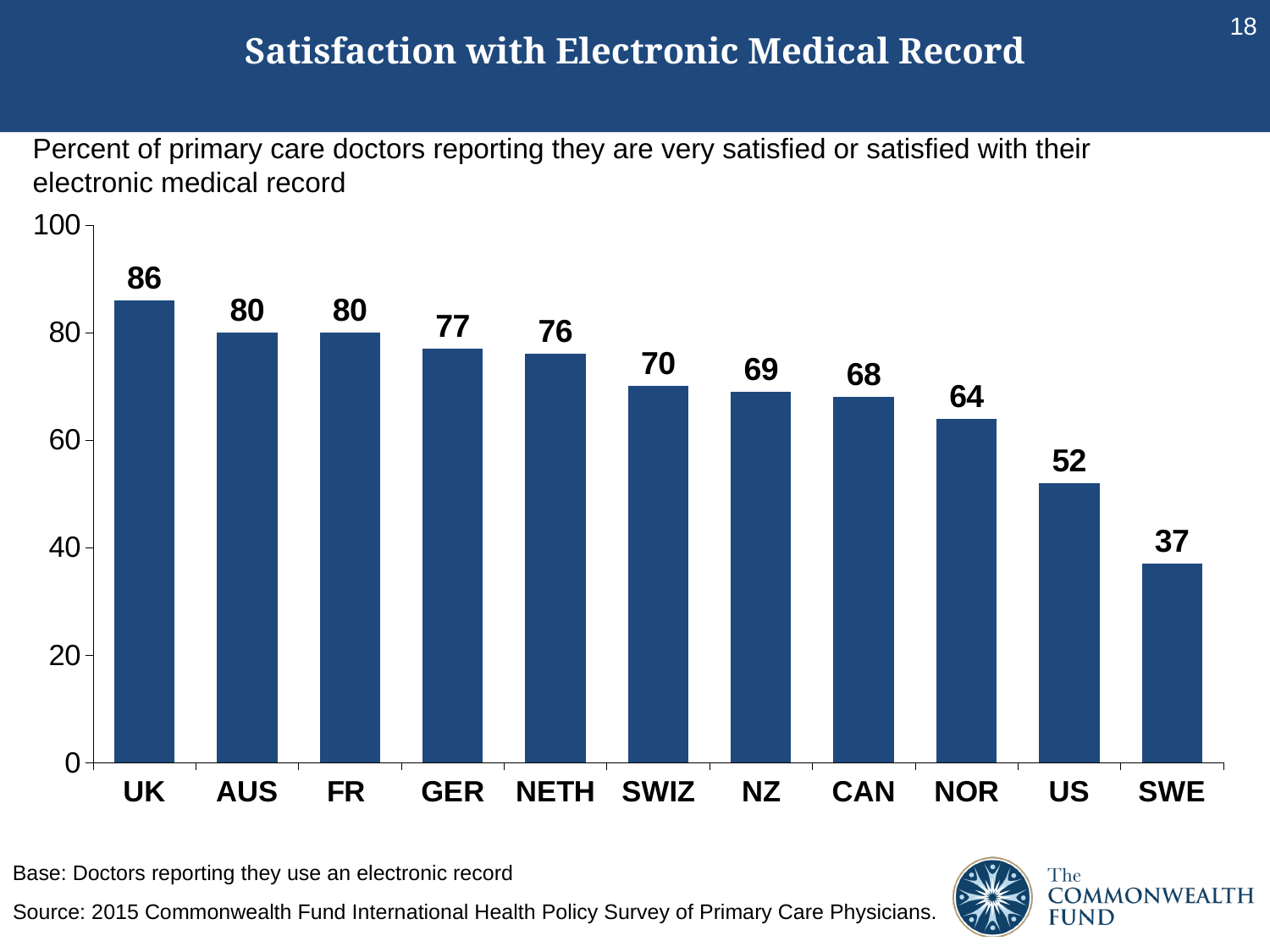
Do the values rise or fall from left to right across the x axis? Fall What is the value for the UK? 86 Is the value for SWIZ greater or less than 60? greater What is the value for the US? 52 What kind of chart is shown on the slide? Bar chart Which country has the lowest value? SWE What is the difference between the values for GER and NOR? 13 Which has a larger value, CAN or US? CAN What is the value for NETH? 76 How many countries are shown in the chart? 11 Which country has the highest value? UK What is the difference between the values for the UK and SWE? 49